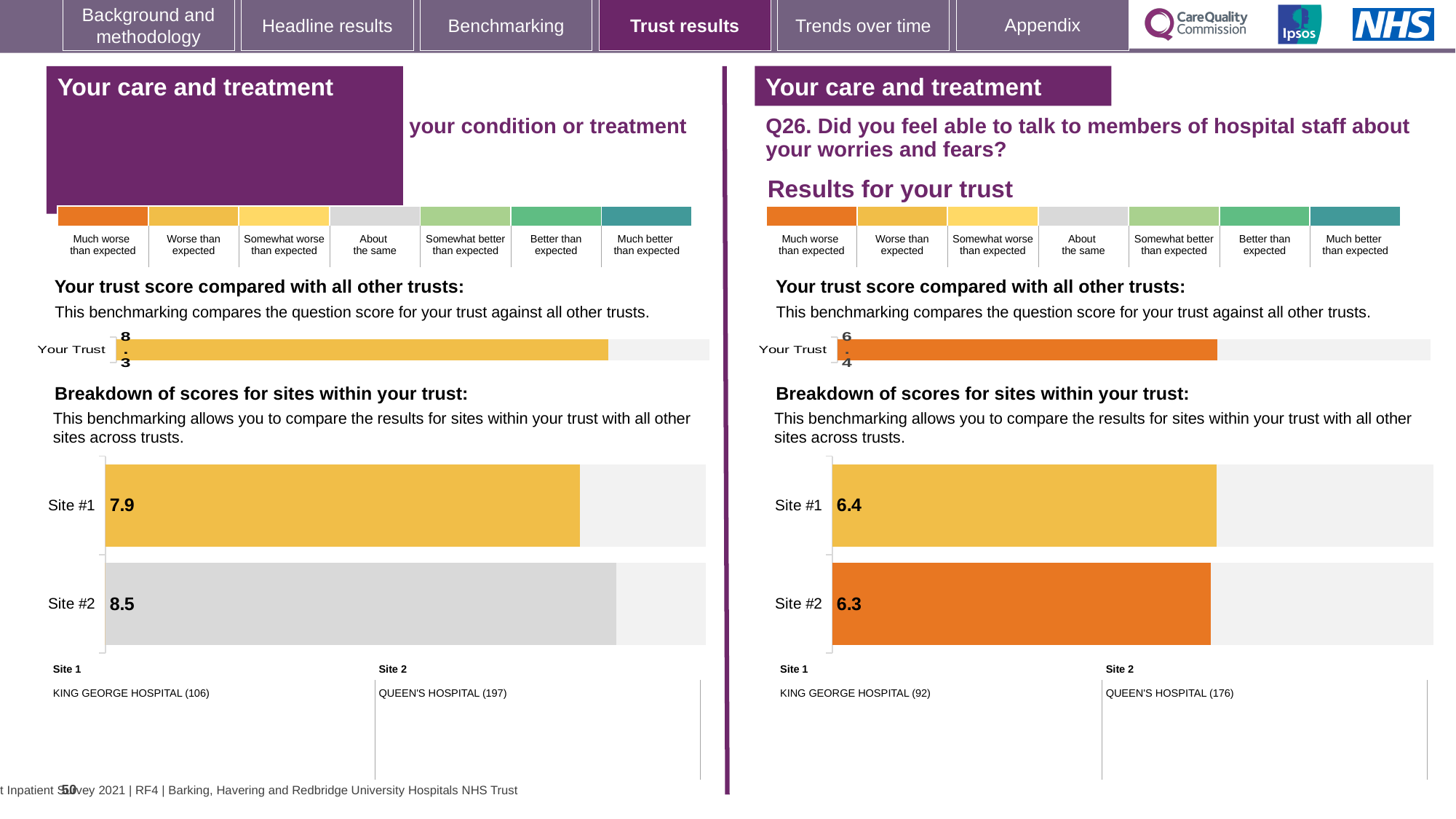
How many sites are shown on the right-hand (Q26) site breakdown chart? 2 What kind of chart is the left-hand 'Breakdown of scores for sites within your trust' chart? Bar chart On the right-hand (Q26) 'Breakdown of scores for sites within your trust' chart, what is the score for Site #1? 6.4 On the right-hand (Q26) site breakdown chart, what is the difference between the Site #1 and Site #2 scores? 0.1 On the right-hand (Q26) 'Your trust score compared with all other trusts' chart, what is the score for Your Trust? 6.4 On the left-hand site breakdown chart, what is the difference between the Site #2 and Site #1 scores? 0.6 On the left-hand 'Your trust score compared with all other trusts' chart, what is the score for Your Trust? 8.3 On the right-hand (Q26) site breakdown chart, which hospital is listed as Site 2? QUEEN'S HOSPITAL (176) On the left-hand site breakdown chart, which site has the higher score, Site #1 or Site #2? Site #2 On the left-hand 'Breakdown of scores for sites within your trust' chart, what is the score for Site #1? 7.9 On the left-hand 'Breakdown of scores for sites within your trust' chart, what is the score for Site #2? 8.5 On the right-hand (Q26) 'Breakdown of scores for sites within your trust' chart, what is the score for Site #2? 6.3